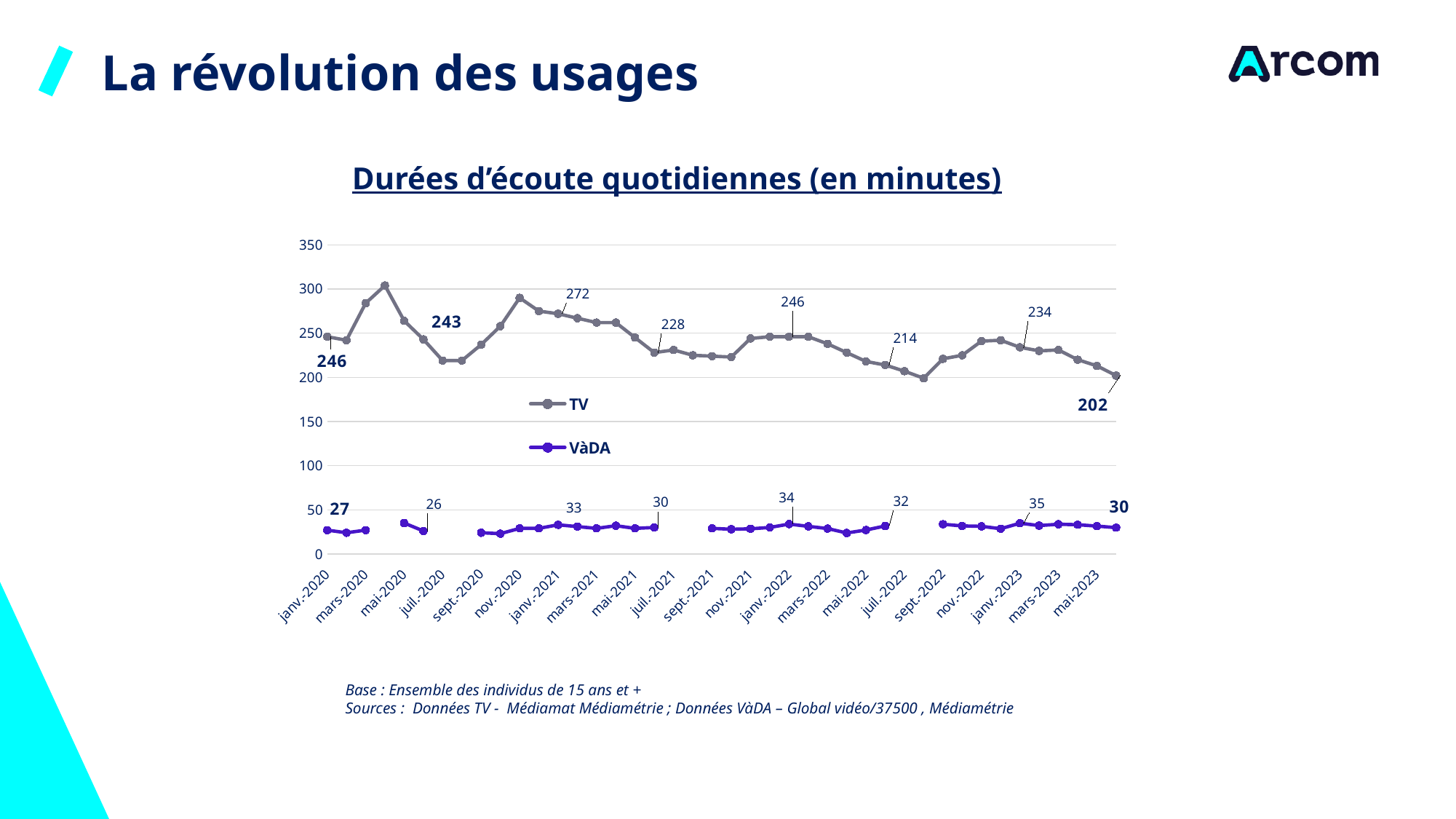
What is the title of the chart? Durées d'écoute quotidiennes (en minutes) What is the last labelled value of the TV series, at the right end of the chart? 202 What is the VàDA value labelled at janv.-2020? 27 What is the TV value labelled at janv.-2020? 246 What is the difference between the first labelled TV value (246) and the last labelled TV value (202)? 44 How many series does the legend list? 2 Is the TV value for juil.-2020 greater or less than 250? less What is the last labelled value of the VàDA series, at the right end of the chart? 30 What kind of chart is shown on the slide? line chart Which series has the higher value at janv.-2020, TV or VàDA? TV Overall, does the TV series rise or fall from janv.-2020 to the end of the chart? fall